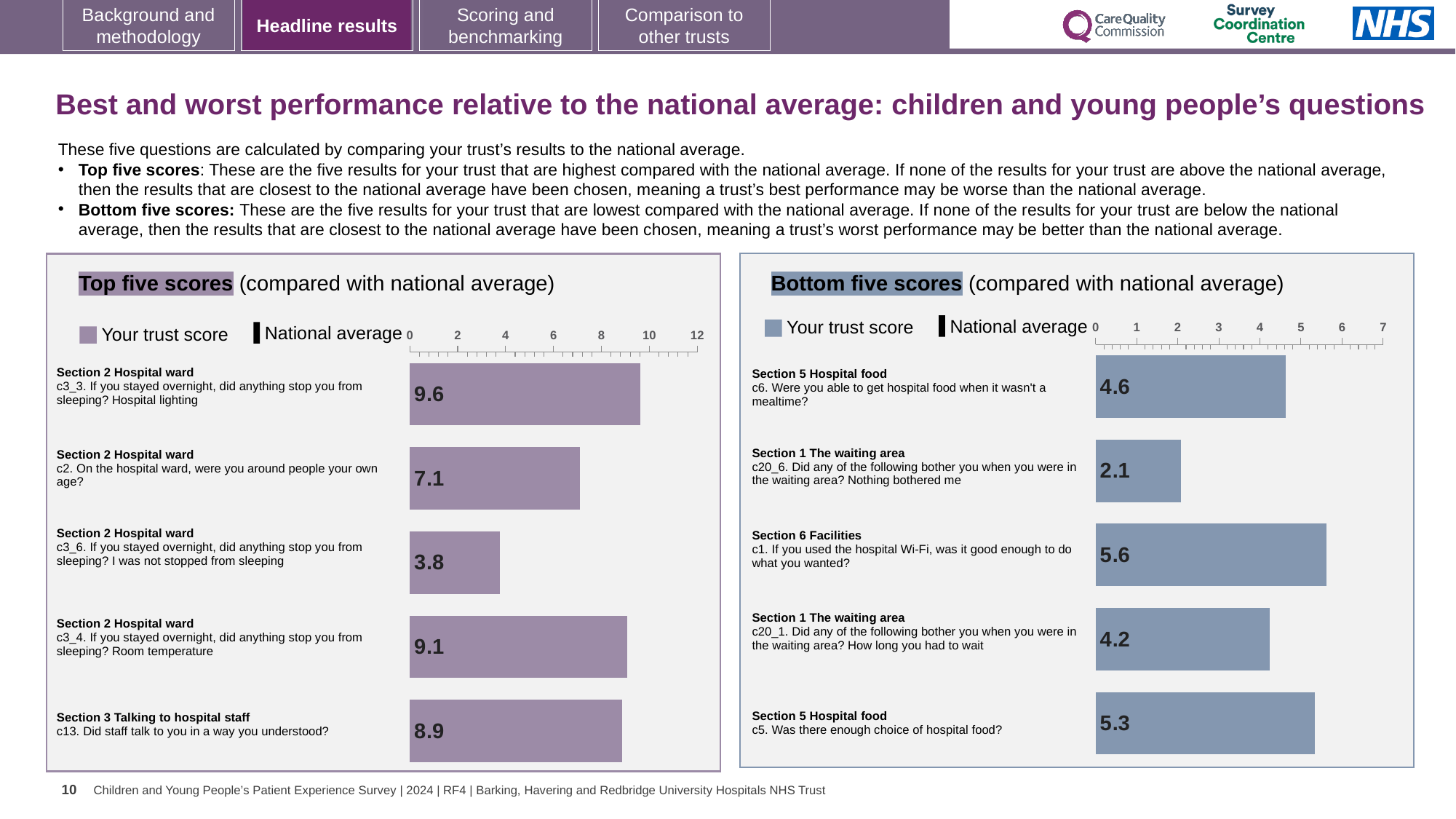
In the Bottom five scores chart, what is the trust score for c1 'If you used the hospital Wi-Fi, was it good enough to do what you wanted?' 5.6 In the Bottom five scores chart, which question has the highest trust score? c1. If you used the hospital Wi-Fi, was it good enough to do what you wanted? In the Top five scores chart, what is the difference between the trust scores for c3_3 (Hospital lighting) and c3_6 (I was not stopped from sleeping)? 5.8 In the Top five scores chart, which has the larger trust score: c3_4 (Room temperature) or c13 (Did staff talk to you in a way you understood?)? c3_4. Room temperature In the Bottom five scores chart, which question has the lowest trust score? c20_6. Did any of the following bother you when you were in the waiting area? Nothing bothered me How many series does the legend of the Bottom five scores chart list? 2 In the Top five scores chart, which question has the highest trust score? c3_3. If you stayed overnight, did anything stop you from sleeping? Hospital lighting What type of chart is the Top five scores chart? Bar chart In the Top five scores chart, what is the trust score for c2 'On the hospital ward, were you around people your own age?' 7.1 In the Top five scores chart, which question has the lowest trust score? c3_6. If you stayed overnight, did anything stop you from sleeping? I was not stopped from sleeping How many questions are shown in the Bottom five scores chart? 5 In the Bottom five scores chart, what is the difference between the trust scores for c1 (hospital Wi-Fi) and c20_6 (Nothing bothered me)? 3.5